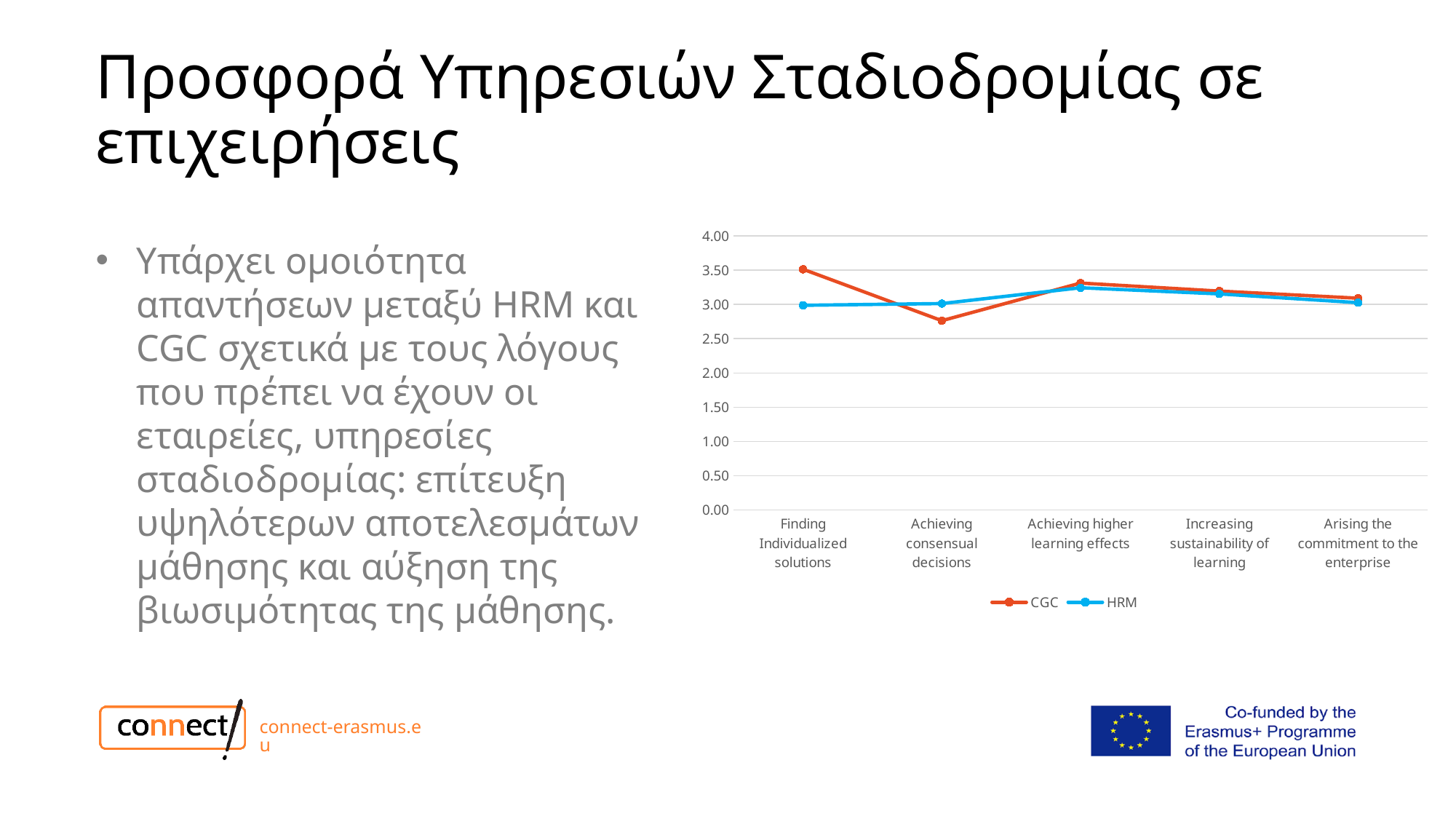
For which category is the CGC value lowest? Achieving consensual decisions Which series has the larger value for Achieving consensual decisions, CGC or HRM? HRM Which colour is used for the HRM series in the legend? blue What kind of chart is shown on the slide? line chart Is the CGC value for Finding Individualized solutions greater or less than 3.00? greater Is the HRM value for Achieving higher learning effects greater or less than 3.00? greater For which category is the CGC value highest? Finding Individualized solutions How many categories are plotted along the x axis? 5 Which series has the larger value for Finding Individualized solutions, CGC or HRM? CGC Do the CGC values rise or fall from Achieving higher learning effects to Arising the commitment to the enterprise? fall Is the CGC value for Achieving consensual decisions greater or less than 3.00? less How many series does the legend list? 2